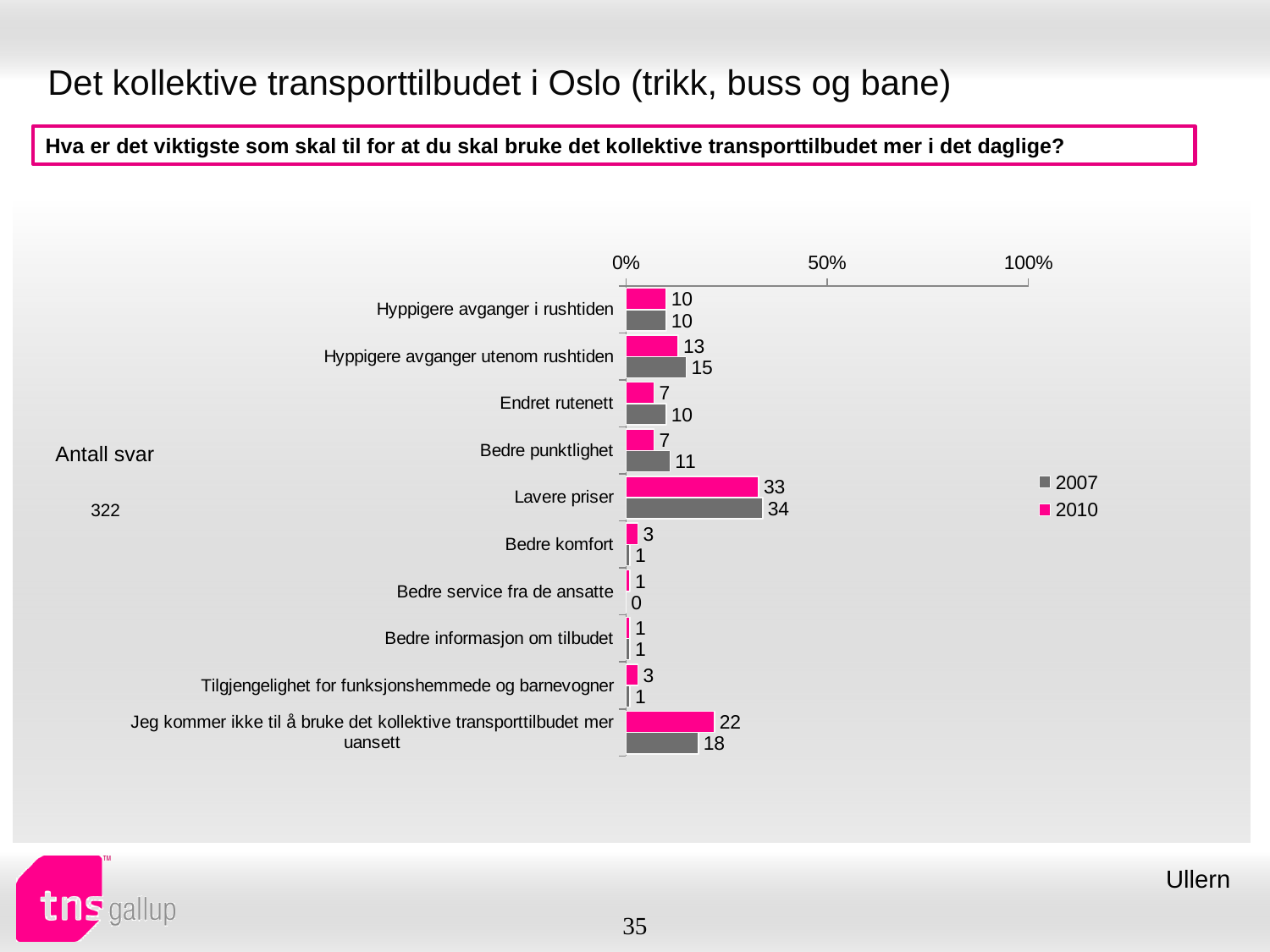
Is the 2007 value for "Lavere priser" greater or less than 50%? less What is the difference between the 2010 and 2007 values for "Jeg kommer ikke til å bruke det kollektive transporttilbudet mer uansett"? 4 What kind of chart is shown on the slide? Bar chart How many series does the legend list? 2 Which colour represents the 2010 series in the legend? Pink Which category has the highest value in the 2007 series? Lavere priser What is the value for "Lavere priser" in the 2010 series? 33 How many categories are shown on the chart? 10 Which category has the lowest value in the 2007 series? Bedre service fra de ansatte What is the value for "Bedre punktlighet" in the 2007 series? 11 What is the value for "Jeg kommer ikke til å bruke det kollektive transporttilbudet mer uansett" in the 2010 series? 22 For "Hyppigere avganger utenom rushtiden", which series has the larger value, 2007 or 2010? 2007